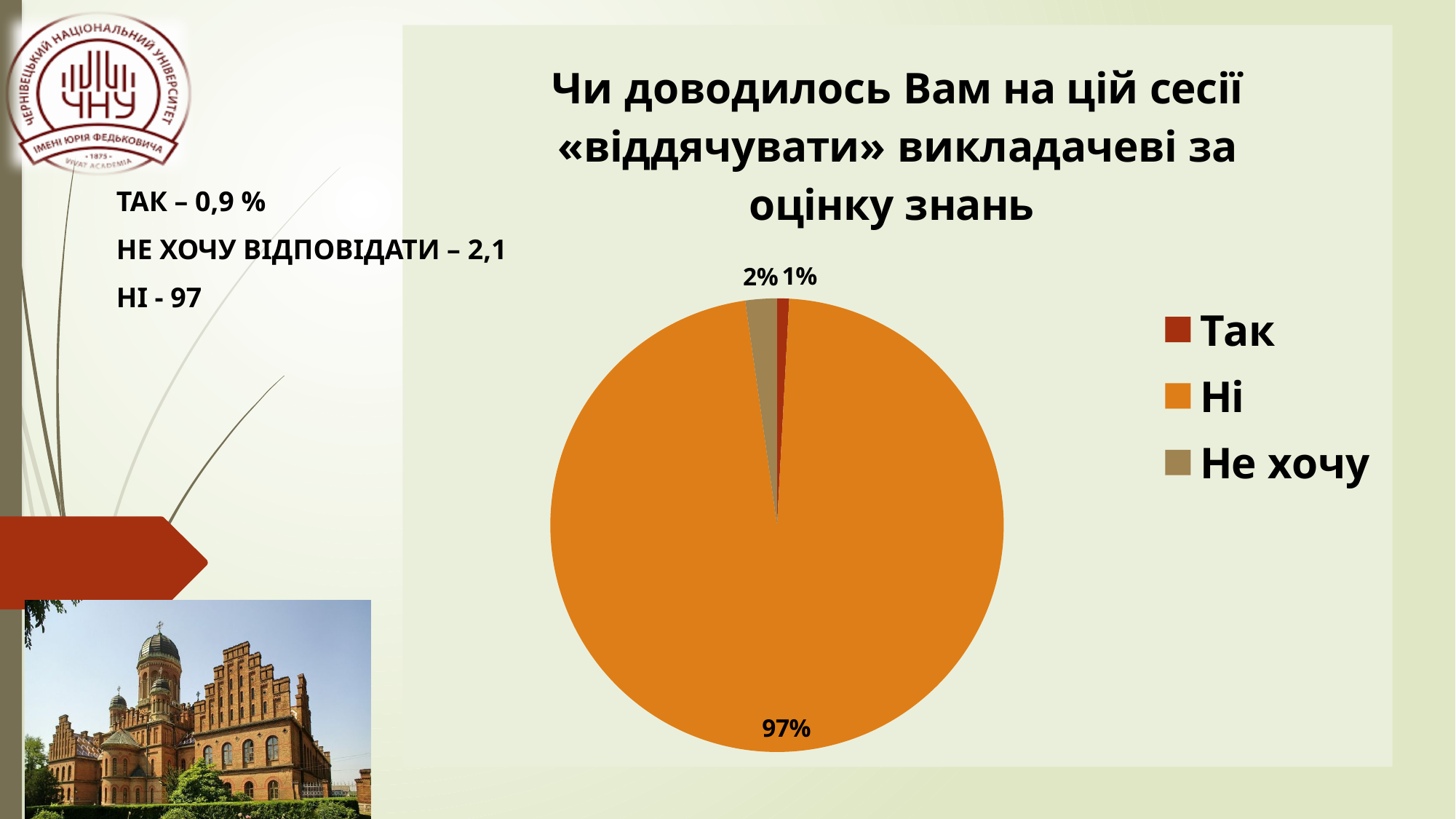
What kind of chart is shown on the slide? pie chart What colour is the "Ні" slice in the pie chart? orange What share of the pie does the "Так" slice represent? 1% How many entries does the legend list? 3 What is the difference in percentage points between the "Ні" slice and the "Не хочу" slice? 95 Which category has the smallest slice of the pie? Так Which is larger, the "Не хочу" slice or the "Так" slice? Не хочу What is the title of the chart? Чи доводилось Вам на цій сесії «віддячувати» викладачеві за оцінку знань What share of the pie does the "Ні" slice represent? 97% Which category has the largest slice of the pie? Ні How many slices does the pie chart have? 3 What share of the pie does the "Не хочу" slice represent? 2%